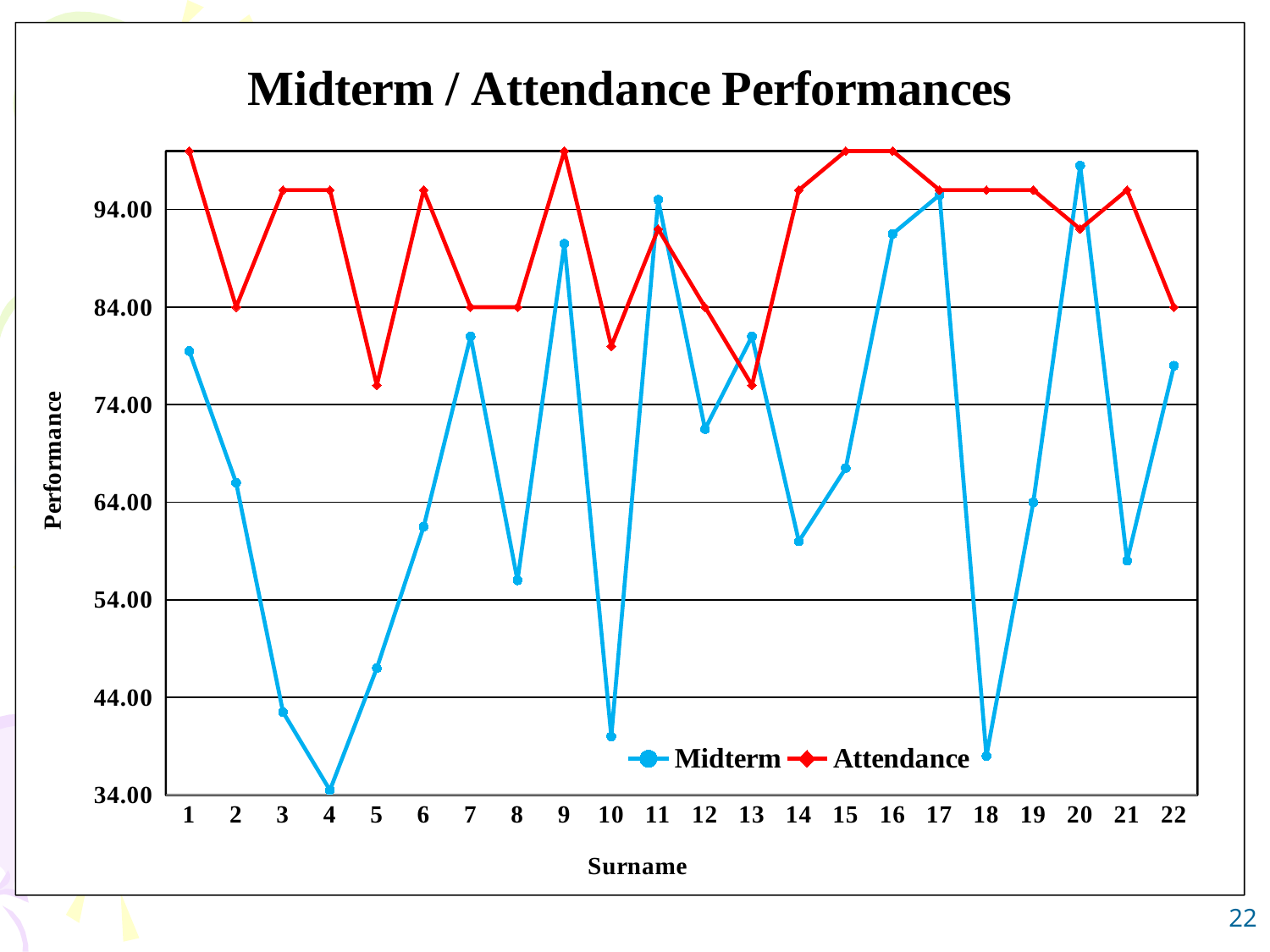
How many series does the legend list? 2 For category 13, which is larger, the Midterm value or the Attendance value? Midterm Is the Attendance value for category 1 greater or less than 94.00? greater What is the Midterm value for category 19? 64.00 Which category has the lowest Midterm value? 4 What is the Attendance value for category 2? 84.00 What is the title of the chart? Midterm / Attendance Performances Which category has the highest Midterm value? 20 What kind of chart is shown on the slide? line chart What is the label of the x axis? Surname Is the Midterm value for category 18 greater or less than 44.00? less How many categories are shown on the x axis? 22